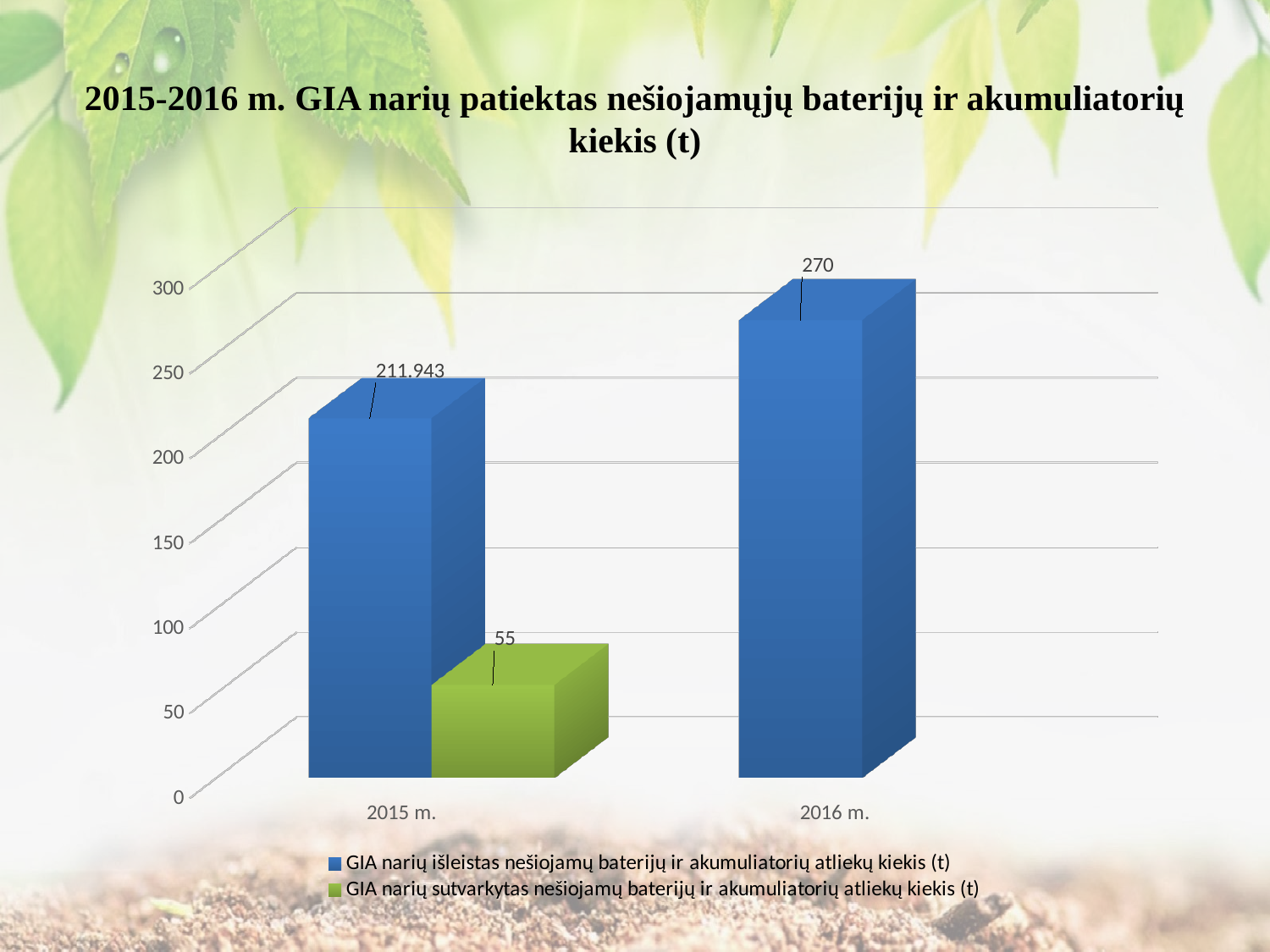
What is the difference between the blue and green series values for 2015 m.? 156.943 Which year has the higher value for the blue series (GIA narių išleistas ... kiekis)? 2016 m. For 2015 m., which is larger: the blue series value or the green series value? The blue series (211.943) Is the value of the green series for 2015 m. greater or less than 100? less What is the value of the blue series (GIA narių išleistas nešiojamų baterijų ir akumuliatorių atliekų kiekis) for 2016 m.? 270 What is the value of the green series (GIA narių sutvarkytas nešiojamų baterijų ir akumuliatorių atliekų kiekis) for 2015 m.? 55 What kind of chart is shown on the slide? Bar chart How many series does the legend list? 2 What is the difference between the blue series values for 2016 m. and 2015 m.? 58.057 Does the blue series rise or fall from 2015 m. to 2016 m.? Rises What is the value of the blue series (GIA narių išleistas nešiojamų baterijų ir akumuliatorių atliekų kiekis) for 2015 m.? 211.943 How many year categories are shown on the x axis? 2